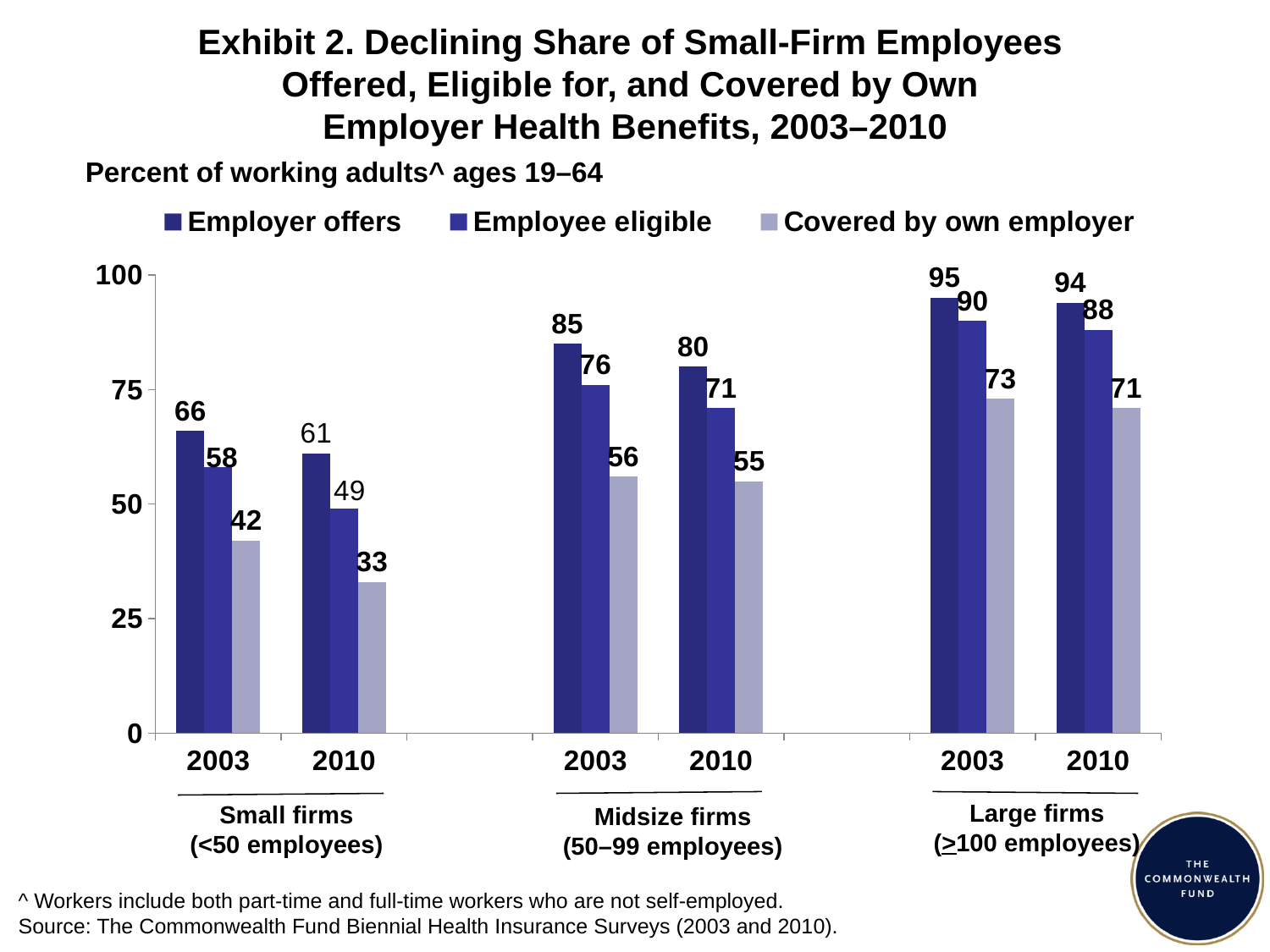
Which group and year has the lowest Covered by own employer value? Small firms, 2010 What kind of chart is shown on the slide? Bar chart What is the difference between the Employer offers values for small firms in 2003 and 2010? 5 What is the value for Employer offers for large firms in 2003? 95 From 2003 to 2010, do the Covered by own employer values for midsize firms rise or fall? Fall How many series does the legend list? 3 What is the difference between Employee eligible and Covered by own employer for large firms in 2010? 17 What is the value for Covered by own employer for small firms in 2010? 33 What is the value for Employer offers for small firms in 2003? 66 Which group and year has the highest Employer offers value? Large firms, 2003 Which is larger: Covered by own employer for midsize firms in 2003 or for large firms in 2010? Large firms in 2010 What is the value for Employee eligible for midsize firms in 2010? 71